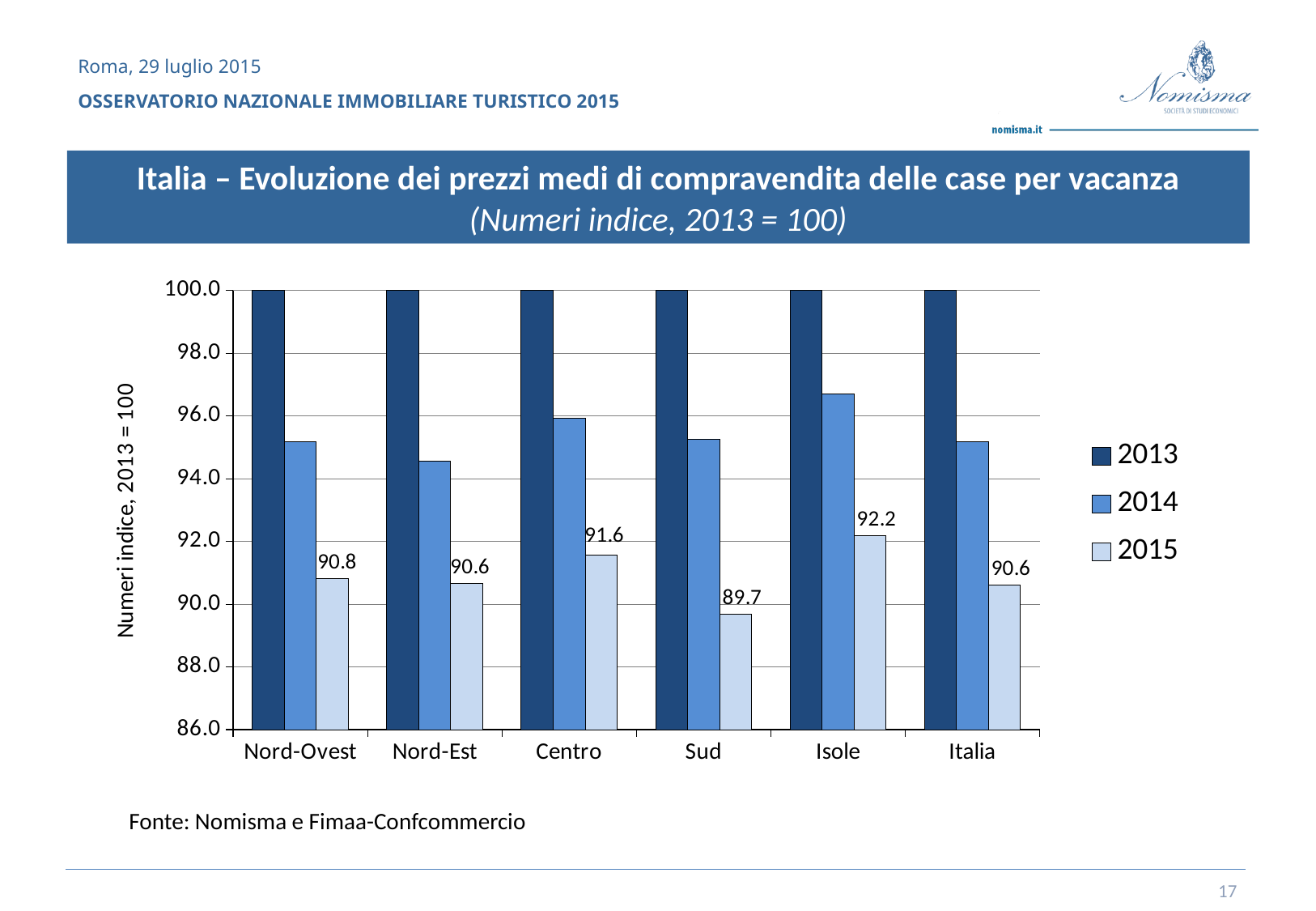
How many categories are shown on the x axis? 6 Which category has the highest 2015 value? Isole What is the difference between the 2015 values for Isole and Sud? 2.5 Is the 2014 value for Nord-Est greater or less than 96.0? less What is the 2015 value for Sud? 89.7 Which category has the lowest 2015 value? Sud Which has the larger 2015 value, Nord-Ovest or Nord-Est? Nord-Ovest What is the 2015 value for Centro? 91.6 What kind of chart is shown on the slide? bar chart Is the 2014 value for Isole greater or less than 96.0? greater What is the 2015 value for Isole? 92.2 How many series does the legend list? 3